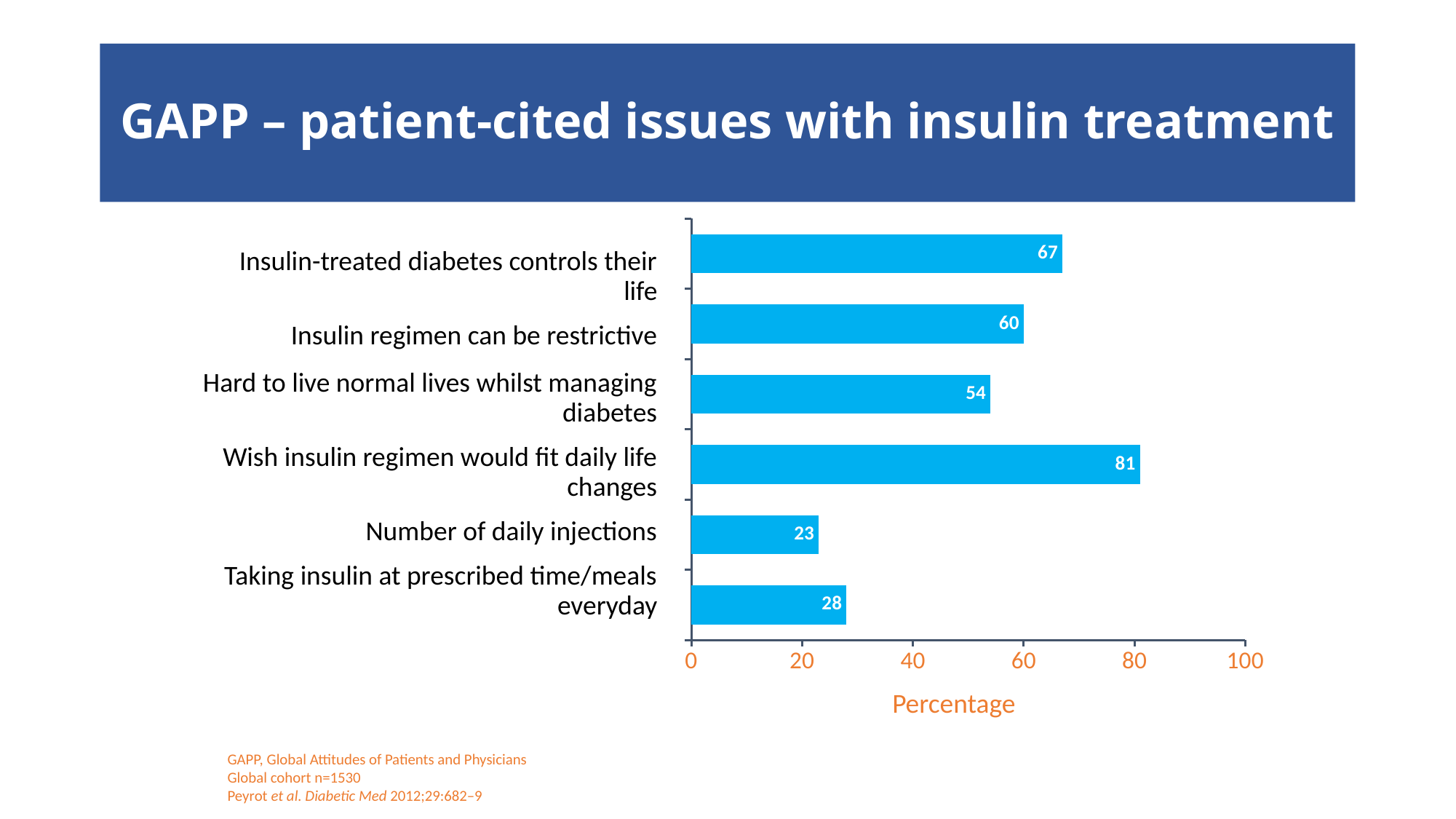
What percentage is shown for 'Taking insulin at prescribed time/meals everyday'? 28 Which issue has the lowest percentage? Number of daily injections What is the difference between 'Wish insulin regimen would fit daily life changes' and 'Insulin regimen can be restrictive'? 21 What is the value for 'Number of daily injections'? 23 What kind of chart is shown on the slide? bar chart Is the value for 'Hard to live normal lives whilst managing diabetes' greater or less than 40? greater Which is larger: 'Insulin regimen can be restrictive' or 'Hard to live normal lives whilst managing diabetes'? Insulin regimen can be restrictive What is the maximum value shown on the horizontal axis? 100 What percentage of patients said insulin-treated diabetes controls their life? 67 What is the label of the horizontal axis? Percentage Which issue has the highest percentage? Wish insulin regimen would fit daily life changes How many issues are plotted in the chart? 6